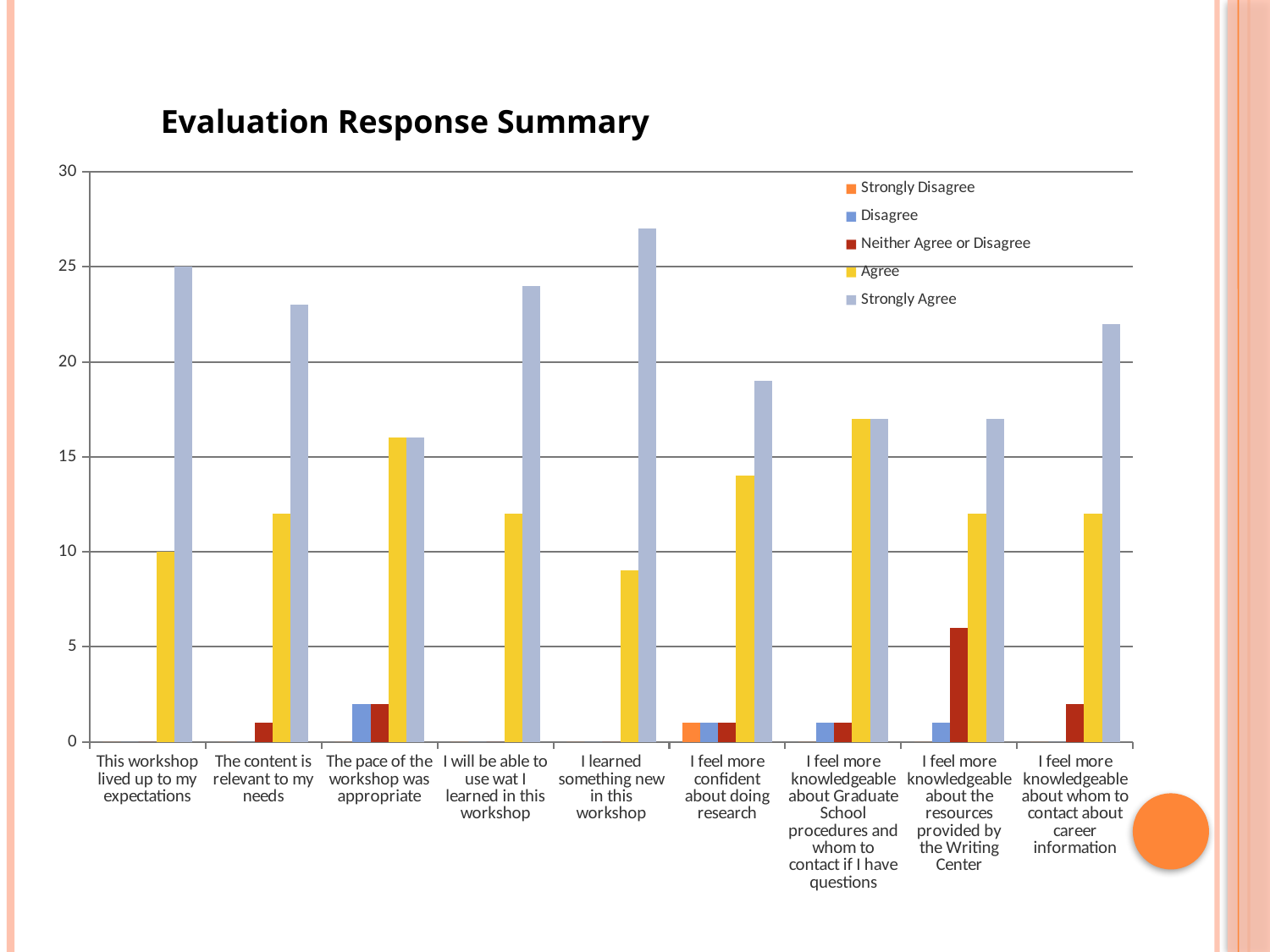
Is the Strongly Agree value for "I feel more confident about doing research" greater or less than 20? less Which is larger for "I feel more confident about doing research": the Agree value or the Strongly Agree value? Strongly Agree Is the Strongly Agree value for "I learned something new in this workshop" greater or less than 25? greater Which colour represents the Agree series in the legend? yellow How many statement categories are shown along the x axis? 9 What is the Strongly Agree value for "This workshop lived up to my expectations"? 25 How many series does the legend list? 5 Which statement has the highest Strongly Agree value? I learned something new in this workshop What kind of chart is shown on the slide? bar chart For "This workshop lived up to my expectations", what is the difference between the Strongly Agree and Agree values? 15 What is the title of the chart? Evaluation Response Summary What is the Agree value for "This workshop lived up to my expectations"? 10